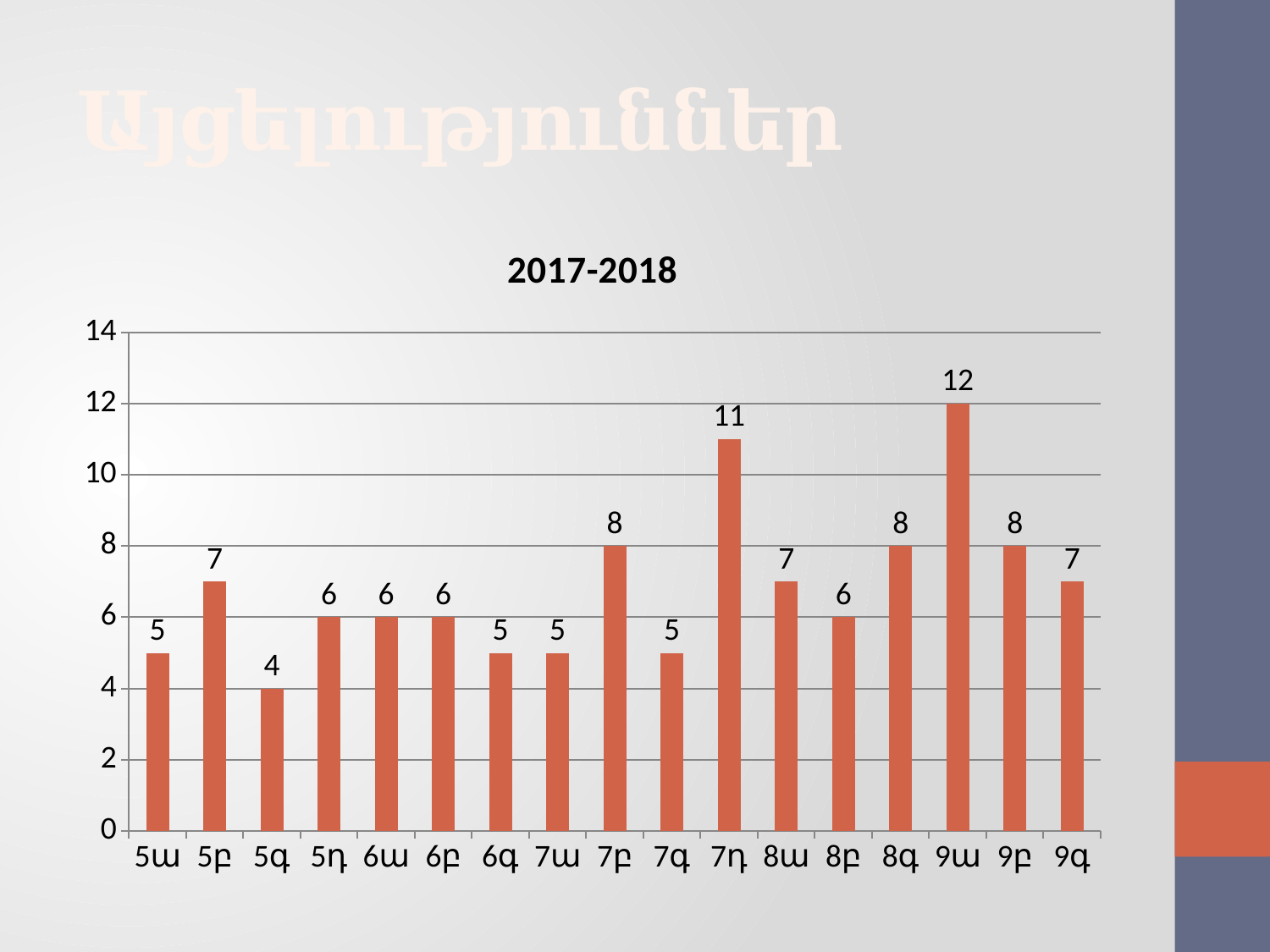
Which category has the highest value? 9ա What is the value for 7դ? 11 What is the value for 8գ? 8 How many categories are shown on the x axis? 17 What is the title of the chart? 2017-2018 What is the difference between the values for 9ա and 5գ? 8 What kind of chart is shown on the slide? Bar chart What is the difference between the values for 7դ and 7գ? 6 Which is larger, the value for 5բ or the value for 5դ? 5բ What is the value for 5գ? 4 Which category has the lowest value? 5գ What is the value for 9ա? 12